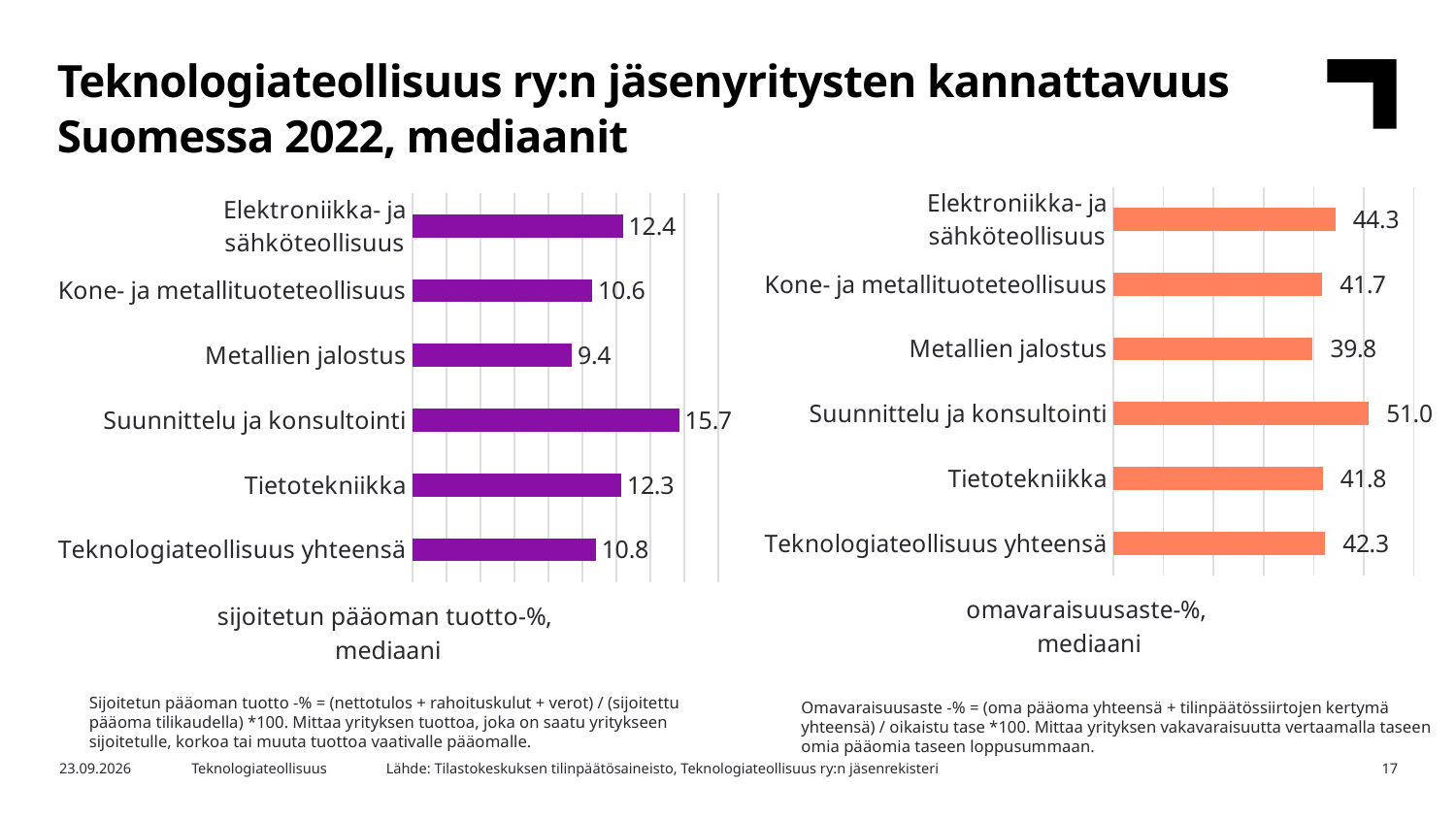
What colour are the bars in the left chart (sijoitetun pääoman tuotto-%, mediaani)? Purple What kind of chart is the right chart (omavaraisuusaste-%, mediaani)? Bar chart In the right chart (omavaraisuusaste-%, mediaani), what is the value for Tietotekniikka? 41.8 In the left chart (sijoitetun pääoman tuotto-%, mediaani), what is the value for Teknologiateollisuus yhteensä? 10.8 In the right chart (omavaraisuusaste-%, mediaani), what is the value for Metallien jalostus? 39.8 In the left chart (sijoitetun pääoman tuotto-%, mediaani), which category has the lowest value? Metallien jalostus How many categories are shown in the left chart (sijoitetun pääoman tuotto-%, mediaani)? 6 In the right chart (omavaraisuusaste-%, mediaani), which is larger: Teknologiateollisuus yhteensä or Tietotekniikka? Teknologiateollisuus yhteensä In the right chart (omavaraisuusaste-%, mediaani), what is the difference between Elektroniikka- ja sähköteollisuus and Kone- ja metallituoteteollisuus? 2.6 In the left chart (sijoitetun pääoman tuotto-%, mediaani), what is the difference between Suunnittelu ja konsultointi and Metallien jalostus? 6.3 In the right chart (omavaraisuusaste-%, mediaani), which category has the highest value? Suunnittelu ja konsultointi In the left chart (sijoitetun pääoman tuotto-%, mediaani), what is the value for Suunnittelu ja konsultointi? 15.7